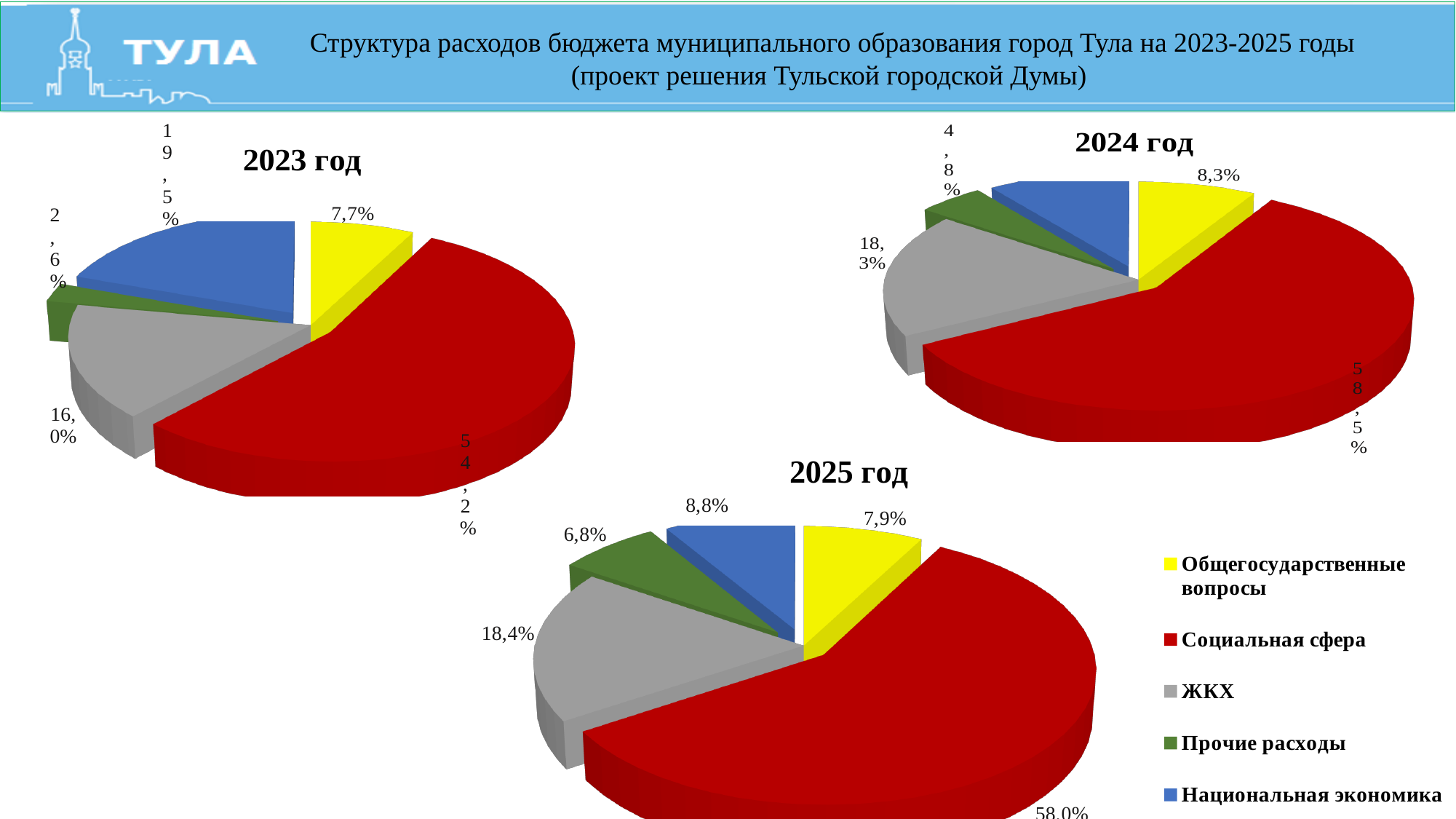
On the 2024 год chart, which category has the largest share? Социальная сфера On the 2025 год chart, what share does Общегосударственные вопросы have? 7,9% On the 2023 год chart, what share does Национальная экономика have? 19,5% On the 2025 год chart, what share does Национальная экономика have? 8,8% On the 2024 год chart, what share does Прочие расходы have? 4,8% On the 2023 год chart, what share does Социальная сфера have? 54,2% How many categories does the legend list for the charts? 5 On the 2023 год chart, which category has the smallest share? Прочие расходы What type of chart is the 2025 год chart? Pie chart On the 2024 год chart, what share does ЖКХ have? 18,3% On the 2025 год chart, which is larger: the share of ЖКХ or the share of Прочие расходы? ЖКХ What is the difference between the share of Социальная сфера on the 2024 год chart and on the 2023 год chart? 4,3%